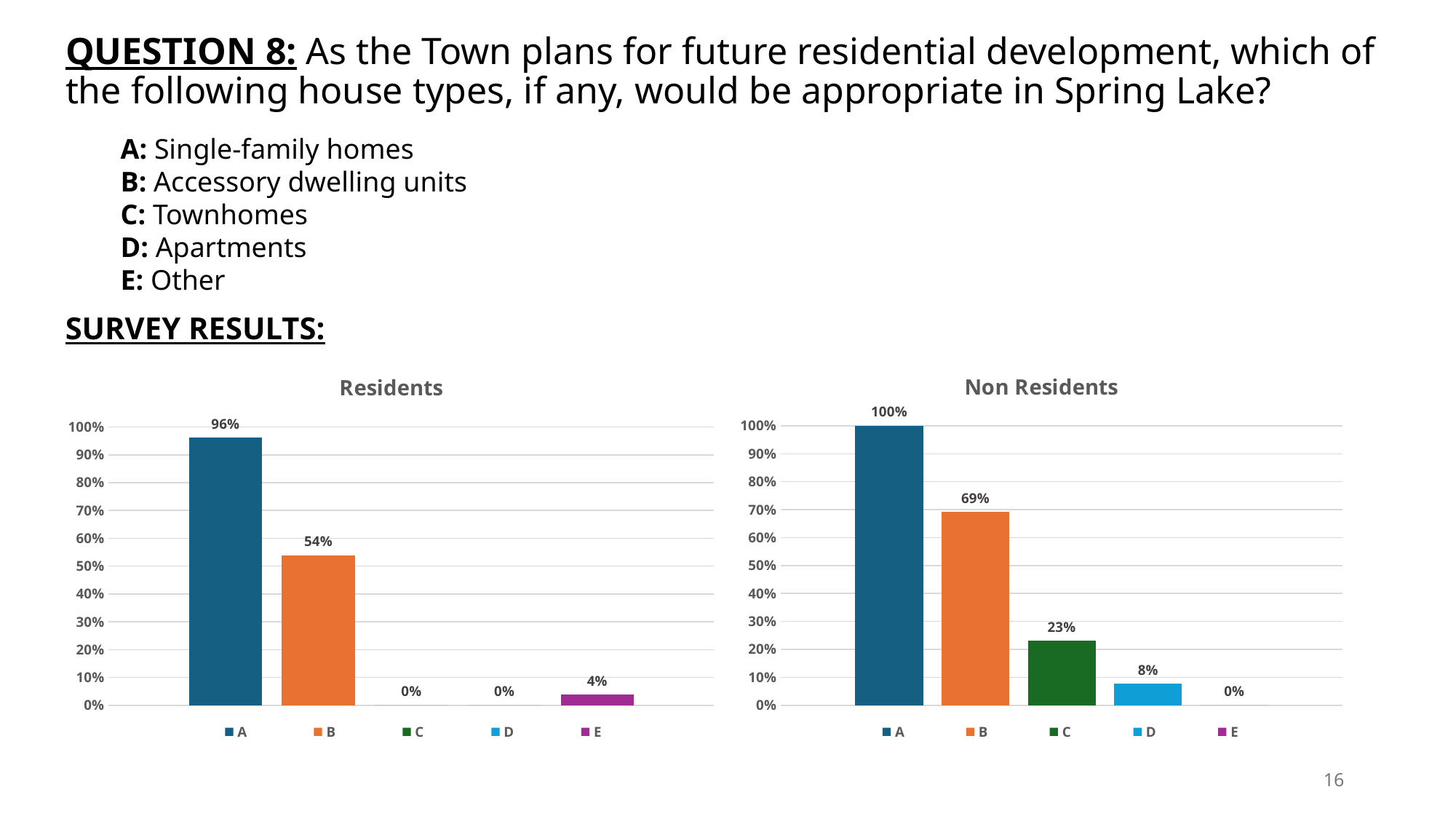
How many categories are shown in the Residents chart? 5 In the Non Residents chart, what is the value for B? 69% In the Non Residents chart, what is the value for C? 23% In the Residents chart, what is the difference between the values for A and B? 42% What kind of chart is the Non Residents chart? Bar chart In the Residents chart, what is the value for A? 96% In the Non Residents chart, what is the difference between the values for C and D? 15% In the Residents chart, what is the value for E? 4% Which is larger: the value for B in the Residents chart or the value for B in the Non Residents chart? Non Residents How many entries does the legend of the Residents chart list? 5 In the Non Residents chart, which category has the lowest value? E In the Non Residents chart, which category has the highest value? A